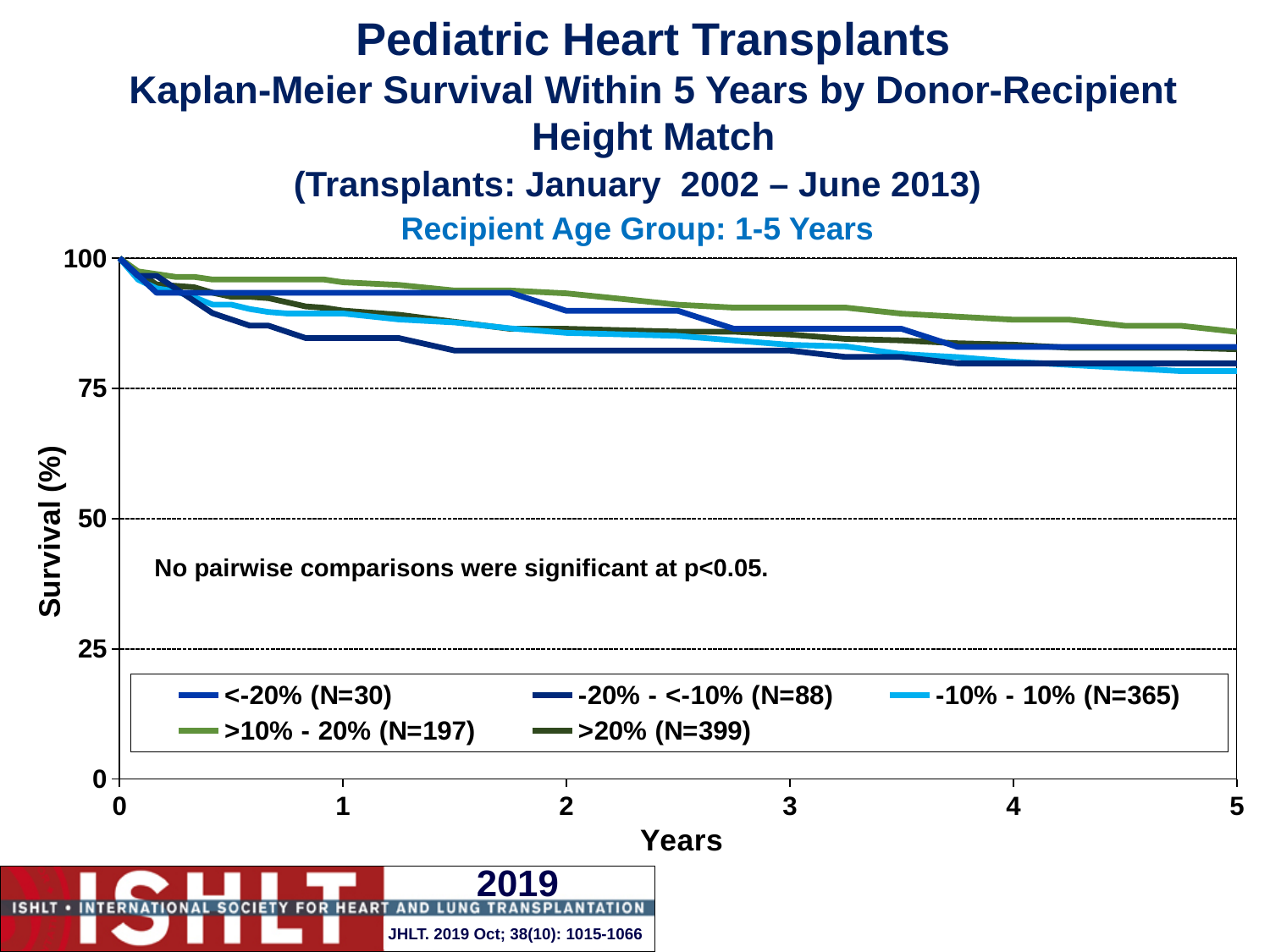
What recipient age group does the chart cover? 1-5 Years How many series does the legend list? 5 Which height-match group has the highest survival at 5 years? >10% - 20% (N=197) Do the survival curves rise or fall as years increase? fall Is the survival for the -10% - 10% group at 5 years greater or less than 75? greater At 5 years, which has higher survival: the >10% - 20% group or the <-20% group? >10% - 20% group Which height-match group has the highest survival at 1 year? >10% - 20% (N=197) Which height-match group has the lowest survival at 1 year? -20% - <-10% (N=88) What kind of chart is shown on the slide? line chart Is the survival for the >10% - 20% group at 5 years greater or less than 75? greater What is the label of the y axis? Survival (%) Is the survival for the <-20% group at 2 years greater or less than 75? greater